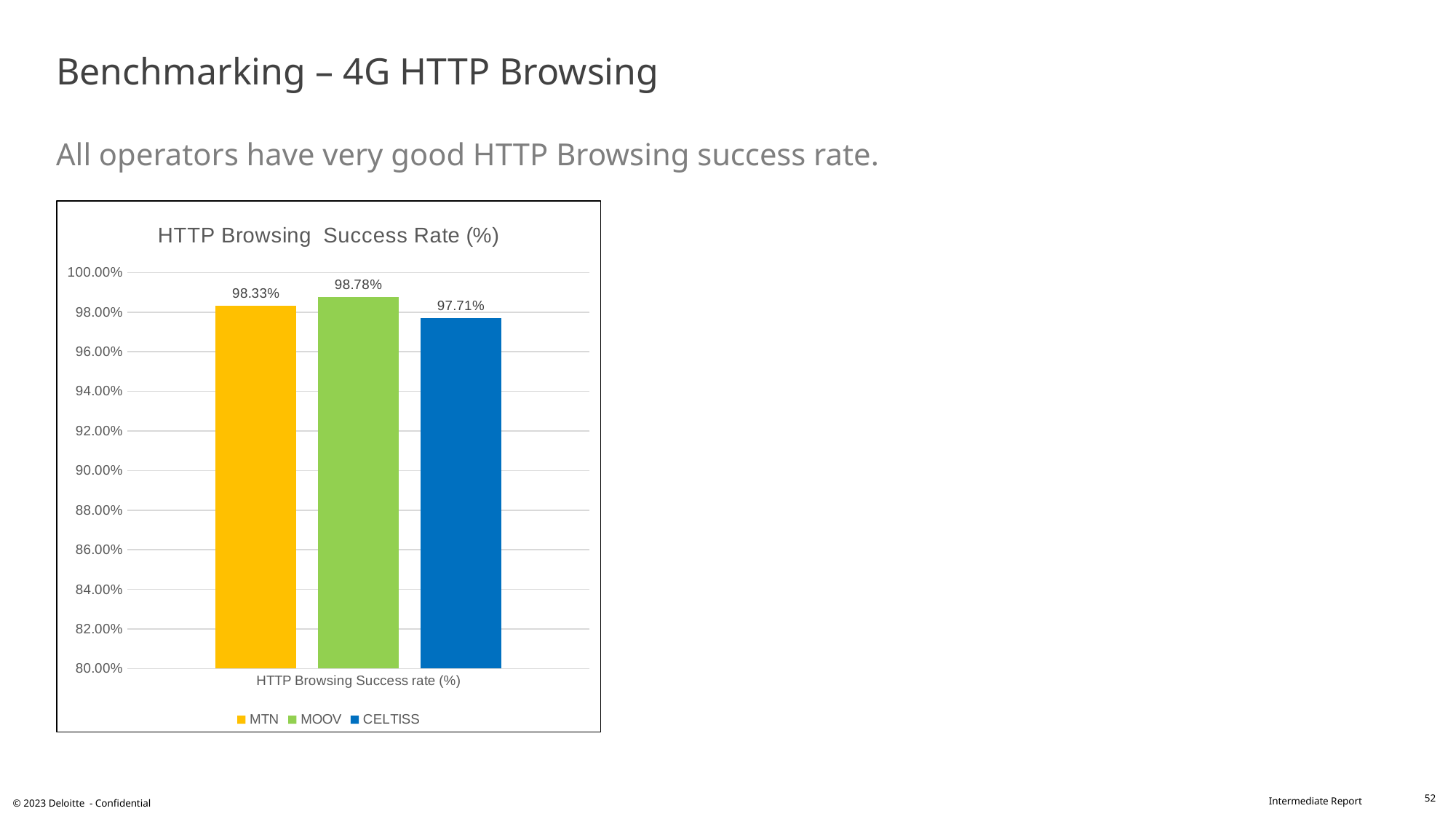
Which has a higher HTTP Browsing success rate, MTN or CELTISS? MTN What is the difference between the HTTP Browsing success rates of MOOV and CELTISS? 1.07% Which operator has the lowest HTTP Browsing success rate? CELTISS What is the HTTP Browsing success rate for MOOV? 98.78% How many series does the legend list? 3 What kind of chart is shown on the slide? Bar chart What is the HTTP Browsing success rate for CELTISS? 97.71% Which operator has the highest HTTP Browsing success rate? MOOV What is the HTTP Browsing success rate for MTN? 98.33% What is the difference between the HTTP Browsing success rates of MOOV and MTN? 0.45% Is the HTTP Browsing success rate for CELTISS greater or less than 98.00%? less What is the title of the chart? HTTP Browsing Success Rate (%)